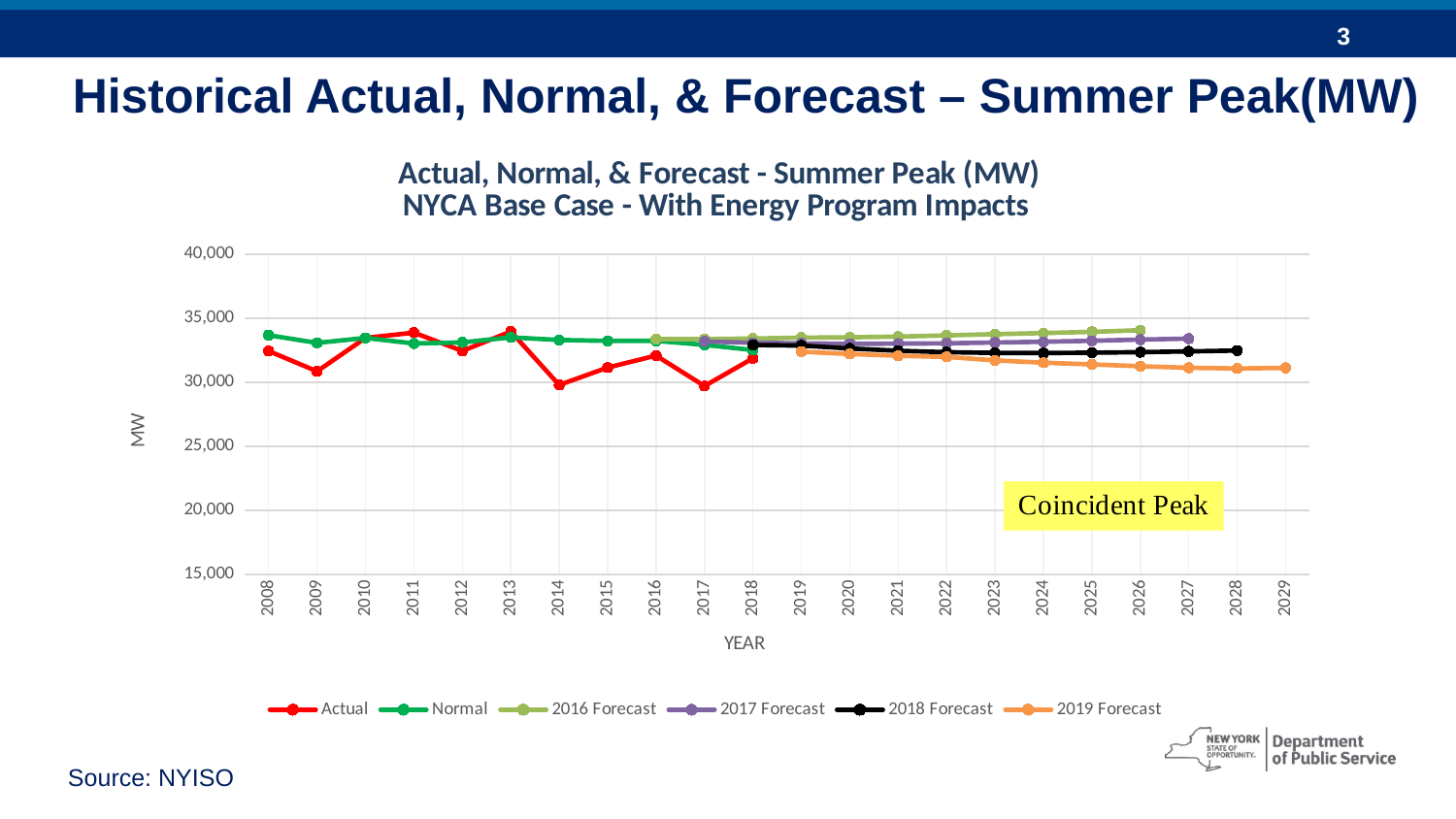
Is the Actual value for 2009 greater or less than 30,000? greater Which series is drawn in red in the chart? Actual What kind of chart is shown on the slide? Line chart How many series does the chart legend list? 6 What is the label on the vertical axis of the chart? MW How many years are shown along the x axis of the chart? 22 Is the Normal value for 2008 greater or less than 30,000? greater Is the Actual value for 2011 greater or less than 35,000? less Does the 2016 Forecast series rise or fall from 2016 to 2026? rise In 2026, which is larger: the 2016 Forecast value or the 2019 Forecast value? 2016 Forecast Does the 2019 Forecast series rise or fall from 2019 to 2029? fall